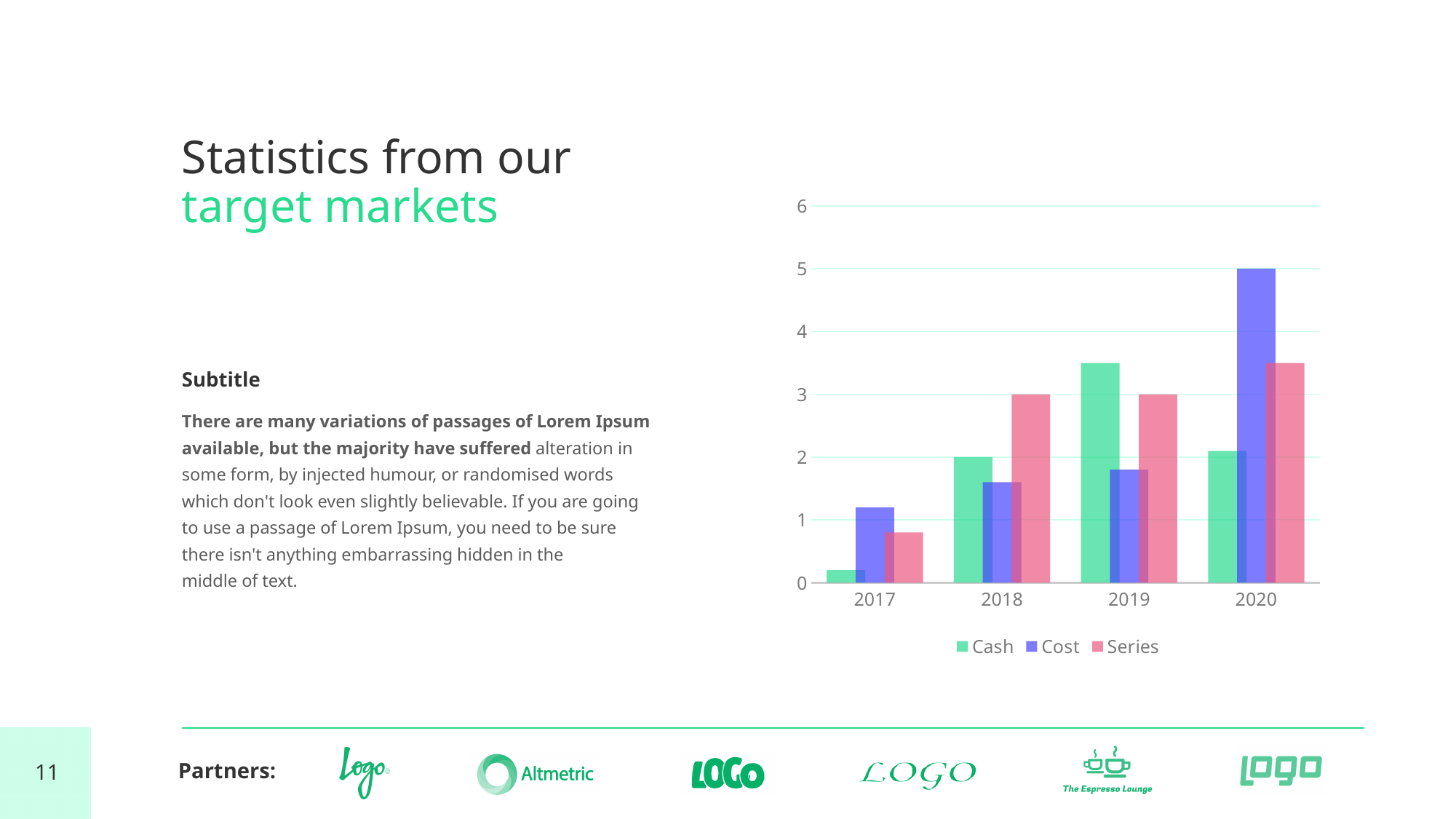
What is the value of Series in 2018? 3 How many series does the legend list? 3 In 2019, which is larger, Cash or Cost? Cash What kind of chart is shown on the slide? bar chart Does the Series value rise or fall from 2017 to 2018? rise How many years are shown on the x axis? 4 What is the value of Cash in 2018? 2 Is the value for Cash in 2019 greater or less than 3? greater Which year has the lowest Cash value? 2017 Which year has the highest Cost value? 2020 What is the difference between Series and Cash in 2018? 1 What is the value of Cost in 2020? 5